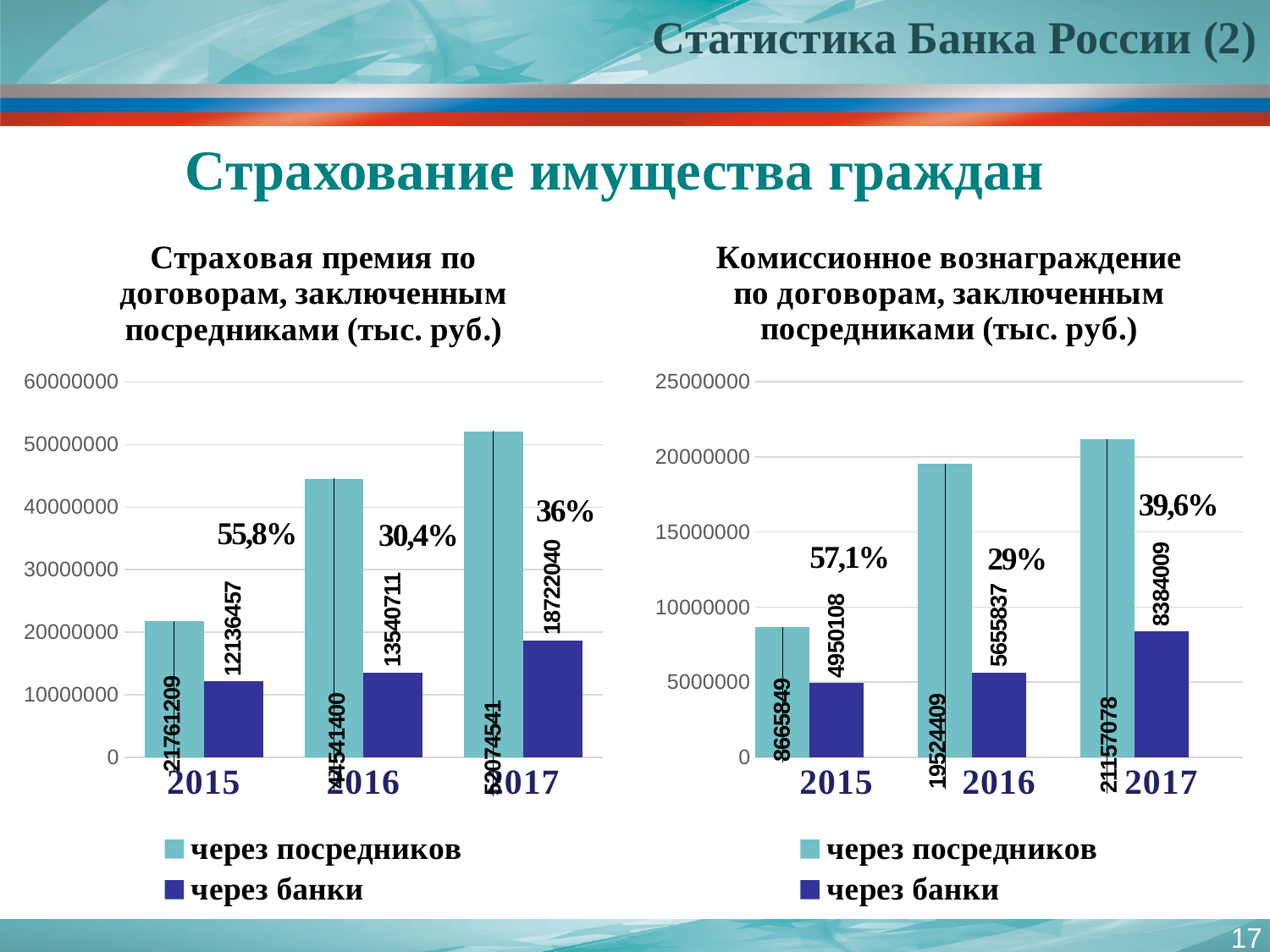
In the right chart (Комиссионное вознаграждение), what is the value for через банки in 2016? 5655837 In the left chart (Страховая премия), what is the difference between the через банки values for 2017 and 2016? 5181329 In the left chart (Страховая премия), which year has the lowest value for через банки? 2015 What type of chart is the left chart (Страховая премия по договорам, заключенным посредниками)? bar chart In the right chart (Комиссионное вознаграждение), which year has the highest value for через посредников? 2017 How many series does the legend of the right chart (Комиссионное вознаграждение) list? 2 In the left chart (Страховая премия по договорам, заключенным посредниками), what is the value for через банки in 2017? 18722040 In the right chart (Комиссионное вознаграждение), what is the value for через посредников in 2017? 21157078 In the left chart (Страховая премия), what is the value for через банки in 2015? 12136457 In the left chart (Страховая премия), is the value for через посредников in 2016 greater or less than 40000000? greater In the right chart (Комиссионное вознаграждение), what is the difference between the через банки values for 2017 and 2015? 3433901 In the right chart (Комиссионное вознаграждение), is the value for через посредников in 2015 greater or less than 10000000? less